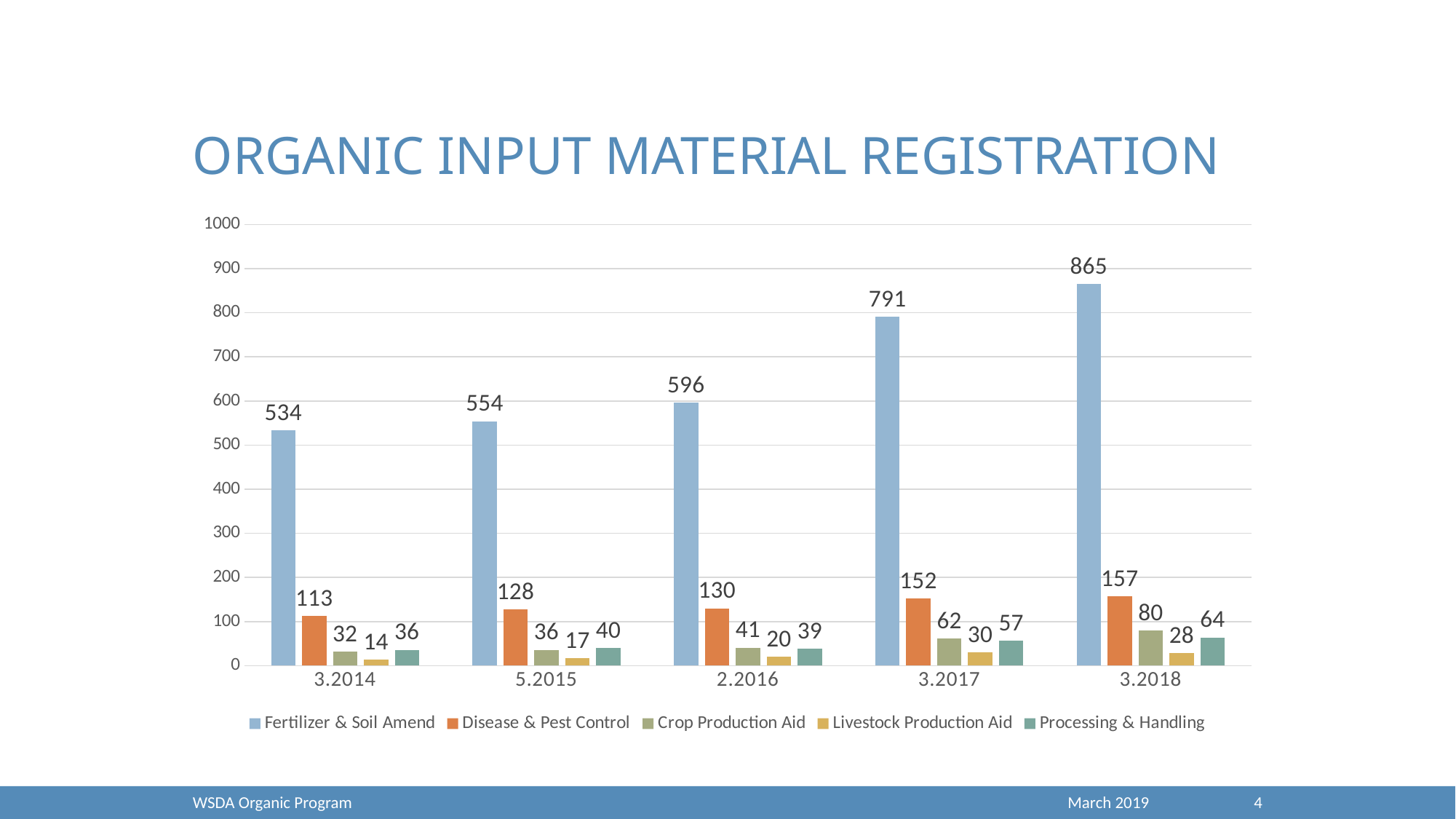
Which is larger: Crop Production Aid in 3.2018 or Processing & Handling in 3.2018? Crop Production Aid What is the value for Processing & Handling in 3.2017? 57 What is the value for Livestock Production Aid in 3.2014? 14 Does the Fertilizer & Soil Amend value rise or fall from 3.2014 to 3.2018? Rise What is the difference between the Fertilizer & Soil Amend values in 3.2018 and 3.2017? 74 What is the value for Disease & Pest Control in 2.2016? 130 What is the value for Fertilizer & Soil Amend in 3.2018? 865 In which period is the Fertilizer & Soil Amend value highest? 3.2018 In which period is the Crop Production Aid value lowest? 3.2014 How many periods are shown on the x axis? 5 How many series does the legend list? 5 What kind of chart is shown on the slide? Bar chart